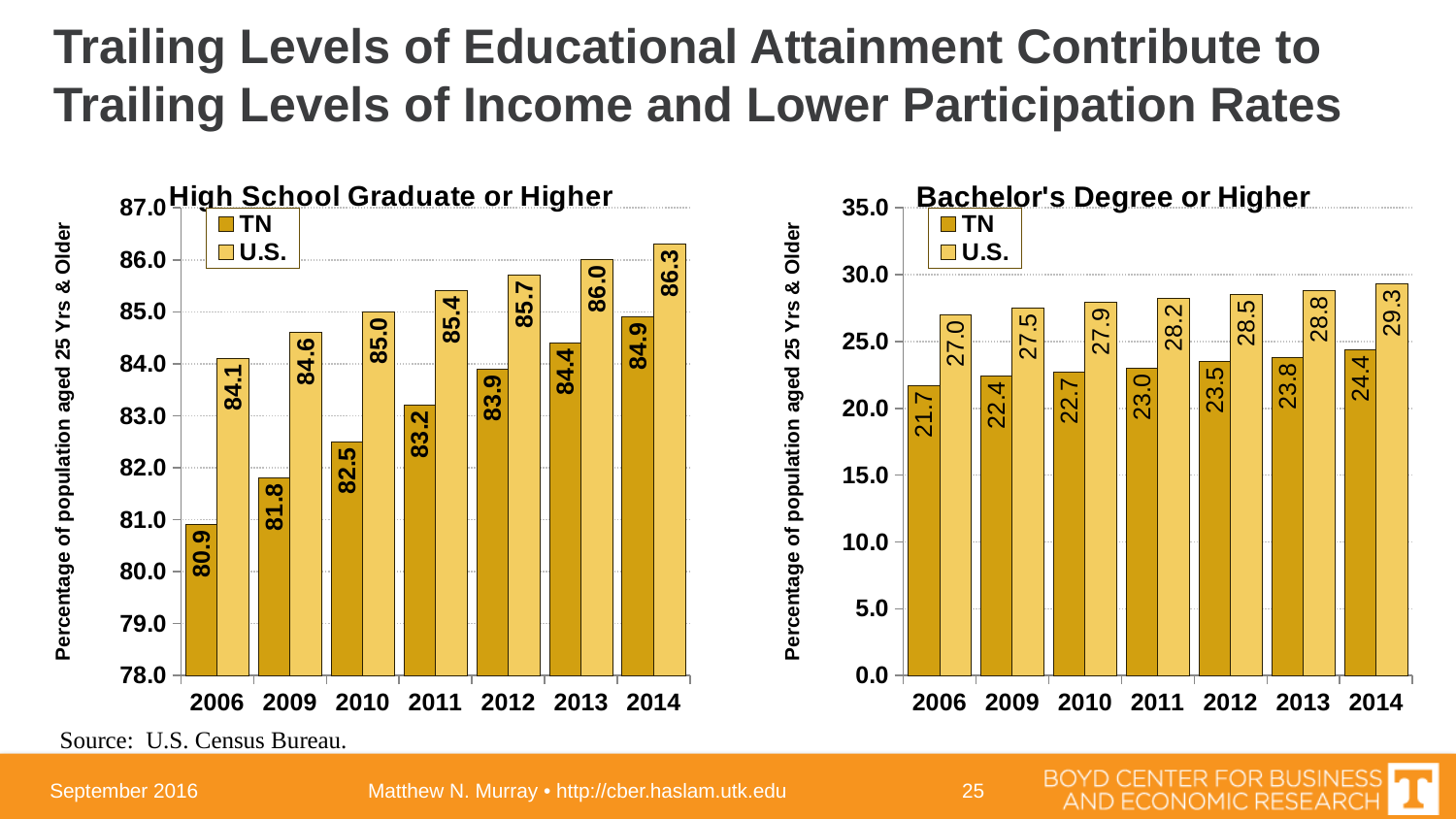
In the 'Bachelor's Degree or Higher' chart, is the TN value for 2014 greater or less than 25.0? less In the 'Bachelor's Degree or Higher' chart, which year has the lowest TN value? 2006 How many series does the legend of the 'Bachelor's Degree or Higher' chart list? 2 In the 'Bachelor's Degree or Higher' chart, what is the U.S. value for 2014? 29.3 How many years are shown on the x axis of the 'High School Graduate or Higher' chart? 7 In the 'Bachelor's Degree or Higher' chart, what is the difference between the U.S. and TN values in 2006? 5.3 In the 'High School Graduate or Higher' chart, which is larger in 2010: the TN value or the U.S. value? U.S. In the 'High School Graduate or Higher' chart, what is the TN value for 2006? 80.9 In the 'Bachelor's Degree or Higher' chart, do the TN values rise or fall from 2006 to 2014? Rise What type of chart is the 'High School Graduate or Higher' chart? Bar chart In the 'High School Graduate or Higher' chart, which year has the highest U.S. value? 2014 In the 'High School Graduate or Higher' chart, what is the difference between the U.S. and TN values in 2014? 1.4